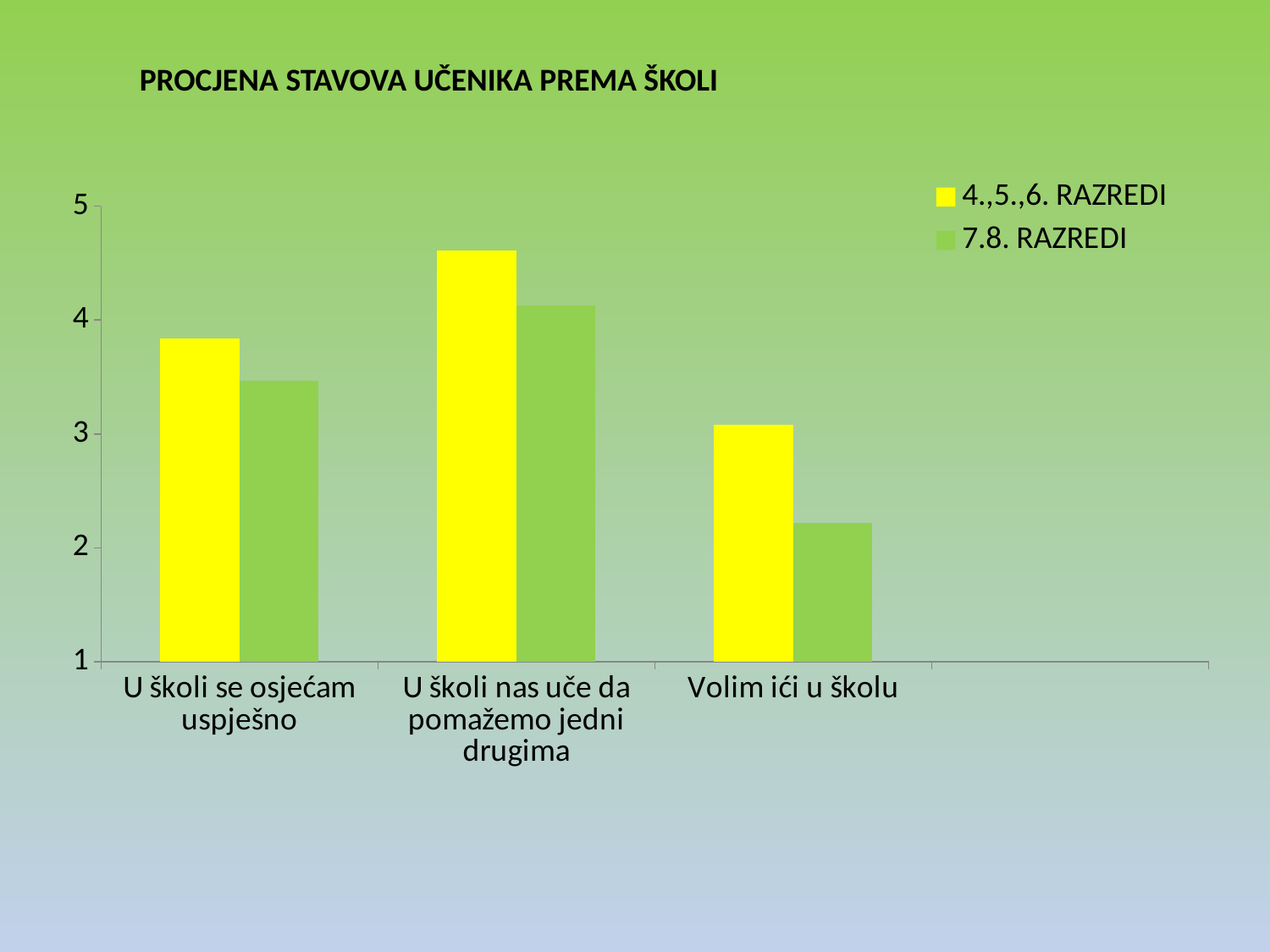
What kind of chart is shown on the slide? bar chart What is the title of the chart? PROCJENA STAVOVA UČENIKA PREMA ŠKOLI How many series does the legend list? 2 How many categories are shown on the x axis? 3 Is the value for 4.,5.,6. RAZREDI in "U školi nas uče da pomažemo jedni drugima" greater or less than 4? greater For the category "Volim ići u školu", which series has the larger value, 4.,5.,6. RAZREDI or 7.8. RAZREDI? 4.,5.,6. RAZREDI For the series 4.,5.,6. RAZREDI, which category has the highest value? U školi nas uče da pomažemo jedni drugima For the category "U školi se osjećam uspješno", which series has the larger value, 4.,5.,6. RAZREDI or 7.8. RAZREDI? 4.,5.,6. RAZREDI Which series is shown in yellow? 4.,5.,6. RAZREDI Is the value for 7.8. RAZREDI in "Volim ići u školu" greater or less than 3? less Is the value for 4.,5.,6. RAZREDI in "U školi se osjećam uspješno" greater or less than 3? greater For the series 7.8. RAZREDI, which category has the lowest value? Volim ići u školu